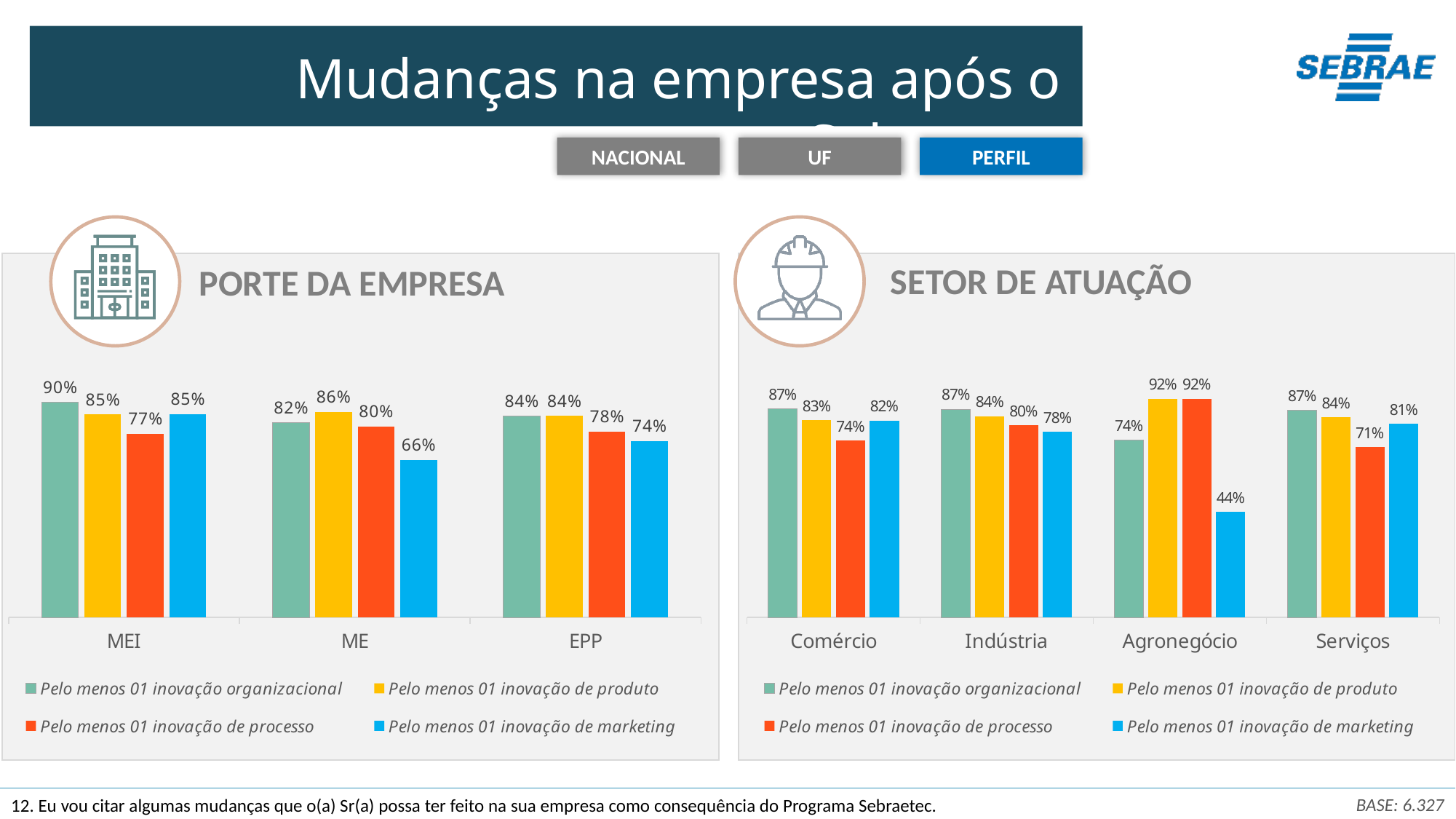
In the PORTE DA EMPRESA chart, what is the value for 'Pelo menos 01 inovação de marketing' for ME? 66% In the SETOR DE ATUAÇÃO chart, which sector has the lowest value for 'Pelo menos 01 inovação de marketing'? Agronegócio In the PORTE DA EMPRESA chart, which is larger for EPP: 'Pelo menos 01 inovação de processo' or 'Pelo menos 01 inovação de marketing'? Pelo menos 01 inovação de processo In the SETOR DE ATUAÇÃO chart, what is the value for 'Pelo menos 01 inovação de processo' for Serviços? 71% How many categories are shown on the x axis of the SETOR DE ATUAÇÃO chart? 4 How many series does the legend of the PORTE DA EMPRESA chart list? 4 In the SETOR DE ATUAÇÃO chart, what is the difference between the 'Pelo menos 01 inovação de produto' and 'Pelo menos 01 inovação de marketing' values for Agronegócio? 48% In the PORTE DA EMPRESA chart, what is the value for 'Pelo menos 01 inovação organizacional' for MEI? 90% What type of chart is the SETOR DE ATUAÇÃO chart? Bar chart In the PORTE DA EMPRESA chart, what is the difference between the 'Pelo menos 01 inovação organizacional' values for MEI and ME? 8% In the SETOR DE ATUAÇÃO chart, which sector has the highest value for 'Pelo menos 01 inovação de produto'? Agronegócio In the SETOR DE ATUAÇÃO chart, what is the value for 'Pelo menos 01 inovação de marketing' for Agronegócio? 44%